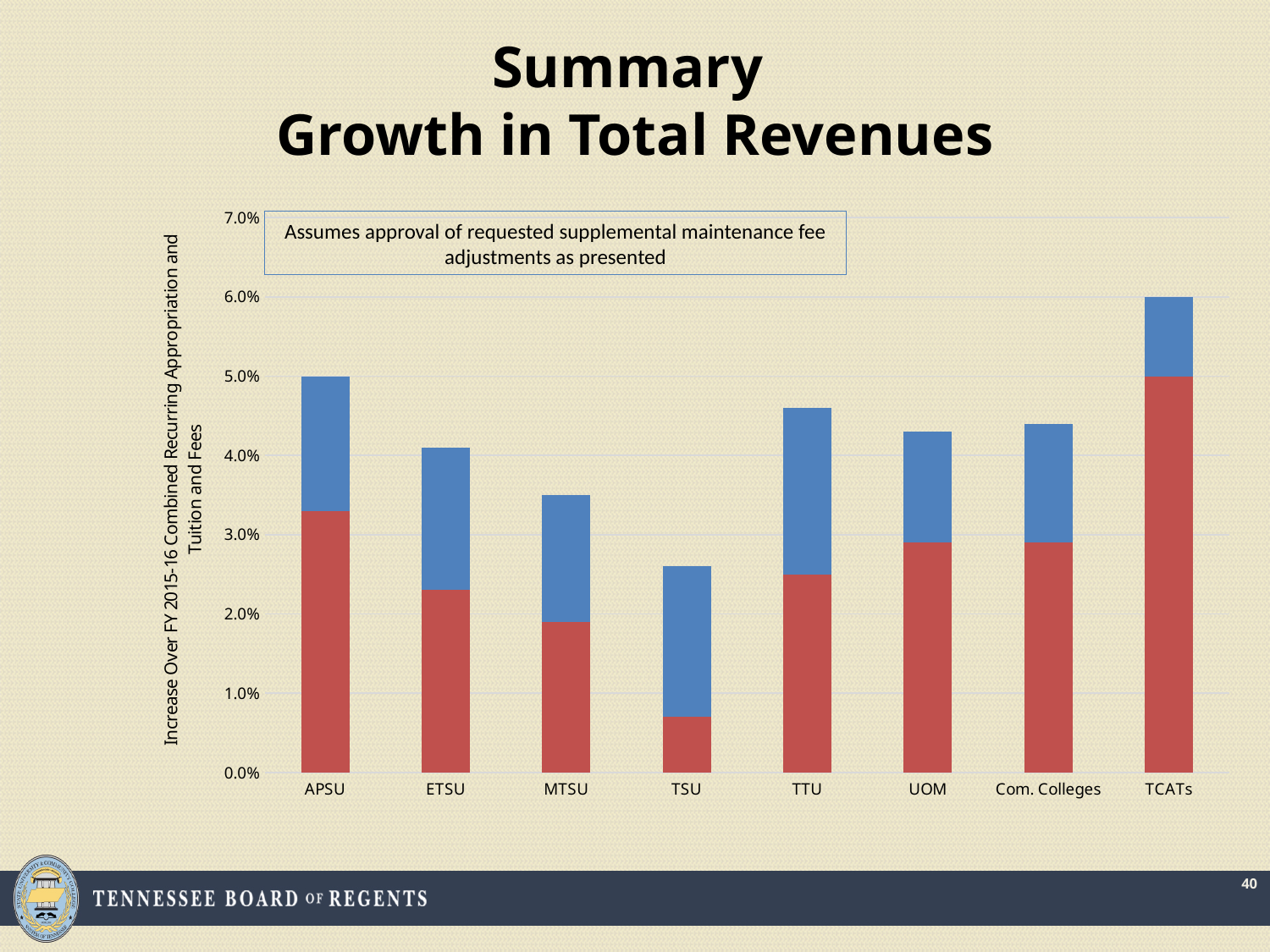
What is the total height of the TCATs bar? 6.0% Which bar is taller, APSU or ETSU? APSU Which category has the shortest bar? TSU What is the title of the vertical axis? Increase Over FY 2015-16 Combined Recurring Appropriation and Tuition and Fees Is the total value for Com. Colleges greater or less than 4.0%? greater Which category has the tallest bar? TCATs Is the total value for TSU greater or less than 3.0%? less What kind of chart is shown on the slide? stacked bar chart How many institutions or categories are shown on the x axis? 8 Is the total value for MTSU greater or less than 3.0%? greater What is the total height of the APSU bar? 5.0% Which bar is taller, TTU or MTSU? TTU